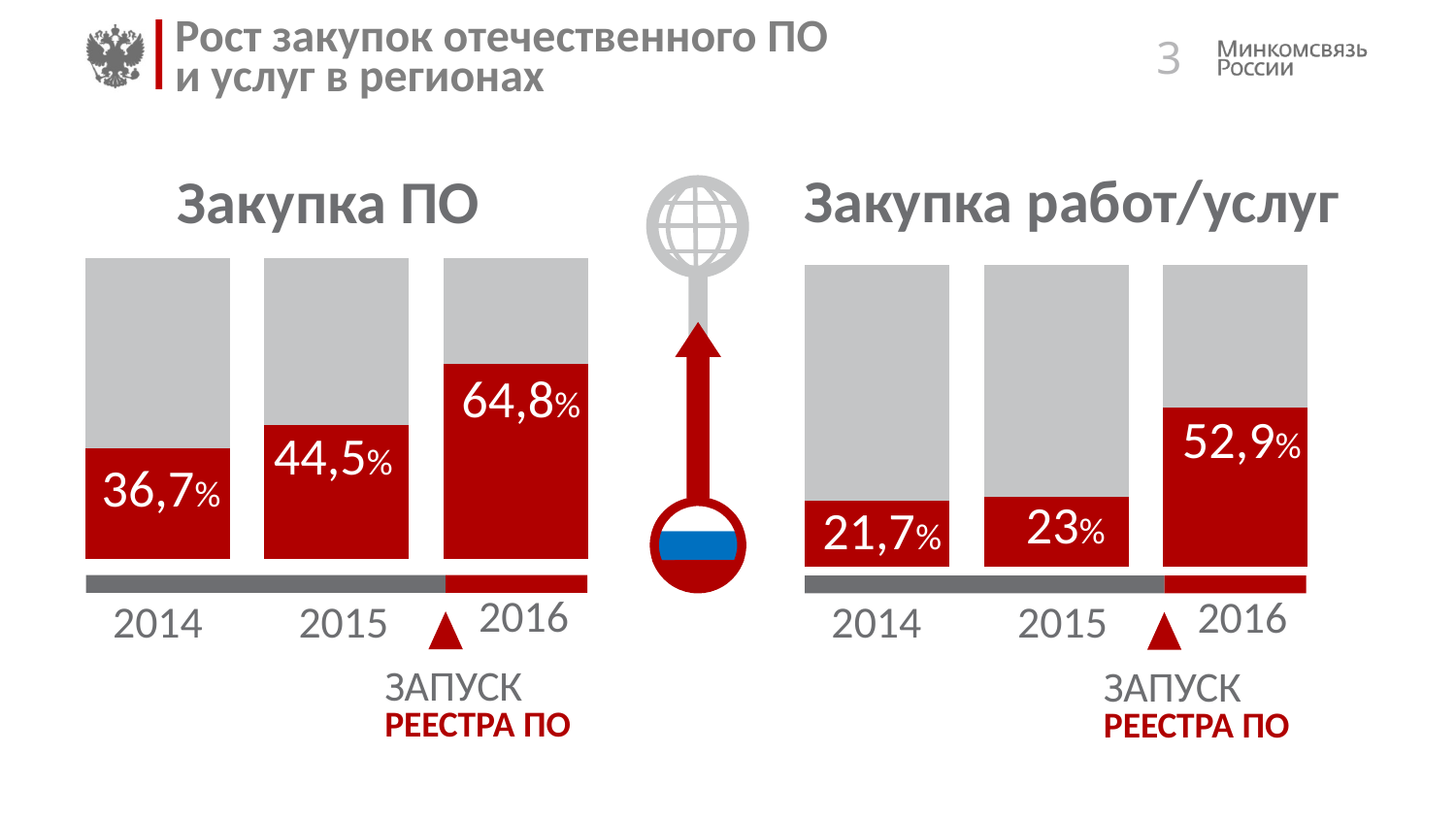
Which is larger: the 2015 value in the 'Закупка ПО' chart or the 2015 value in the 'Закупка работ/услуг' chart? Закупка ПО (44,5%) In the 'Закупка ПО' chart, what is the value for 2014? 36,7% In the 'Закупка работ/услуг' chart, what is the value for 2016? 52,9% In the 'Закупка ПО' chart, what is the difference between the 2016 and 2014 values? 28,1 percentage points In the 'Закупка работ/услуг' chart, what is the difference between the 2016 and 2015 values? 29,9 percentage points In the 'Закупка работ/услуг' chart, which year has the lowest value? 2014 In the 'Закупка работ/услуг' chart, what is the value for 2015? 23% In the 'Закупка ПО' chart, which year has the highest value? 2016 In the 'Закупка ПО' chart, do the values rise or fall from 2014 to 2016? Rise How many years are shown in the 'Закупка работ/услуг' chart? 3 What kind of chart is the 'Закупка ПО' chart? Bar chart In the 'Закупка ПО' chart, what is the value for 2016? 64,8%